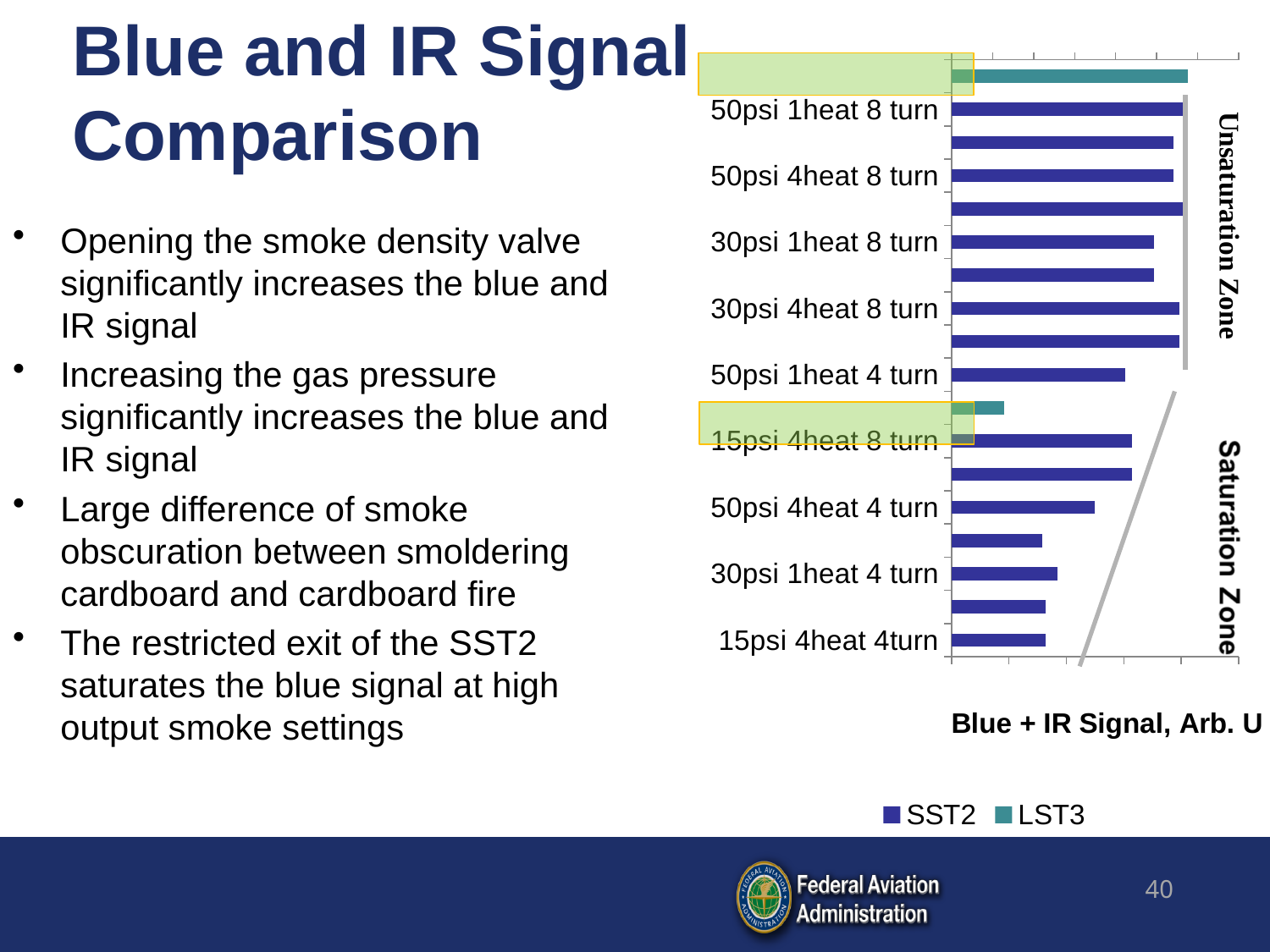
Which is larger, the SST2 bar for 50psi 1heat 4 turn or the SST2 bar for 15psi 4heat 4turn? 50psi 1heat 4 turn Which series is shown in dark blue in the chart? SST2 Which is larger, the SST2 bar for 50psi 1heat 8 turn or the SST2 bar for 15psi 4heat 4turn? 50psi 1heat 8 turn What are the two series named in the chart legend? SST2 and LST3 What is the title of the chart's horizontal axis? Blue + IR Signal, Arb. U Which is larger, the SST2 bar for 50psi 4heat 8 turn or the SST2 bar for 50psi 4heat 4 turn? 50psi 4heat 8 turn What kind of chart is shown on the slide? bar chart How many series does the chart legend list? 2